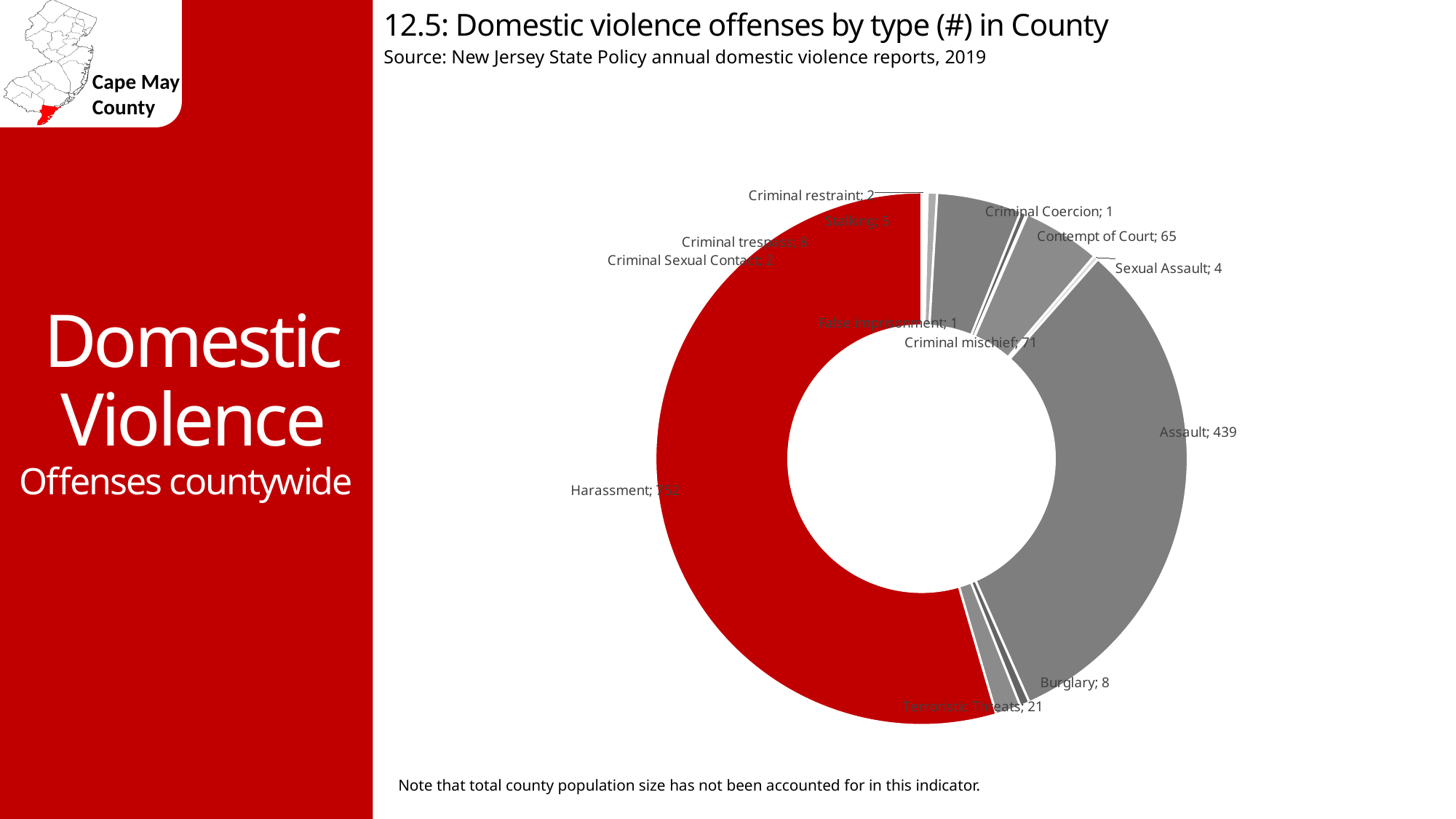
How many domestic violence offenses of type Assault are shown? 439 What is the value for Sexual Assault? 4 What is the value for Terroristic Threats? 21 Which offense type has the largest slice of the chart? Harassment What kind of chart is shown on the slide? doughnut chart Which is larger, Assault or Criminal mischief? Assault What is the difference between Assault and Terroristic Threats? 418 What is the value for Criminal mischief? 71 What is the value for Contempt of Court? 65 How many offense types are shown in the chart? 13 What is the difference between Criminal mischief and Contempt of Court? 6 What is the value for Burglary? 8